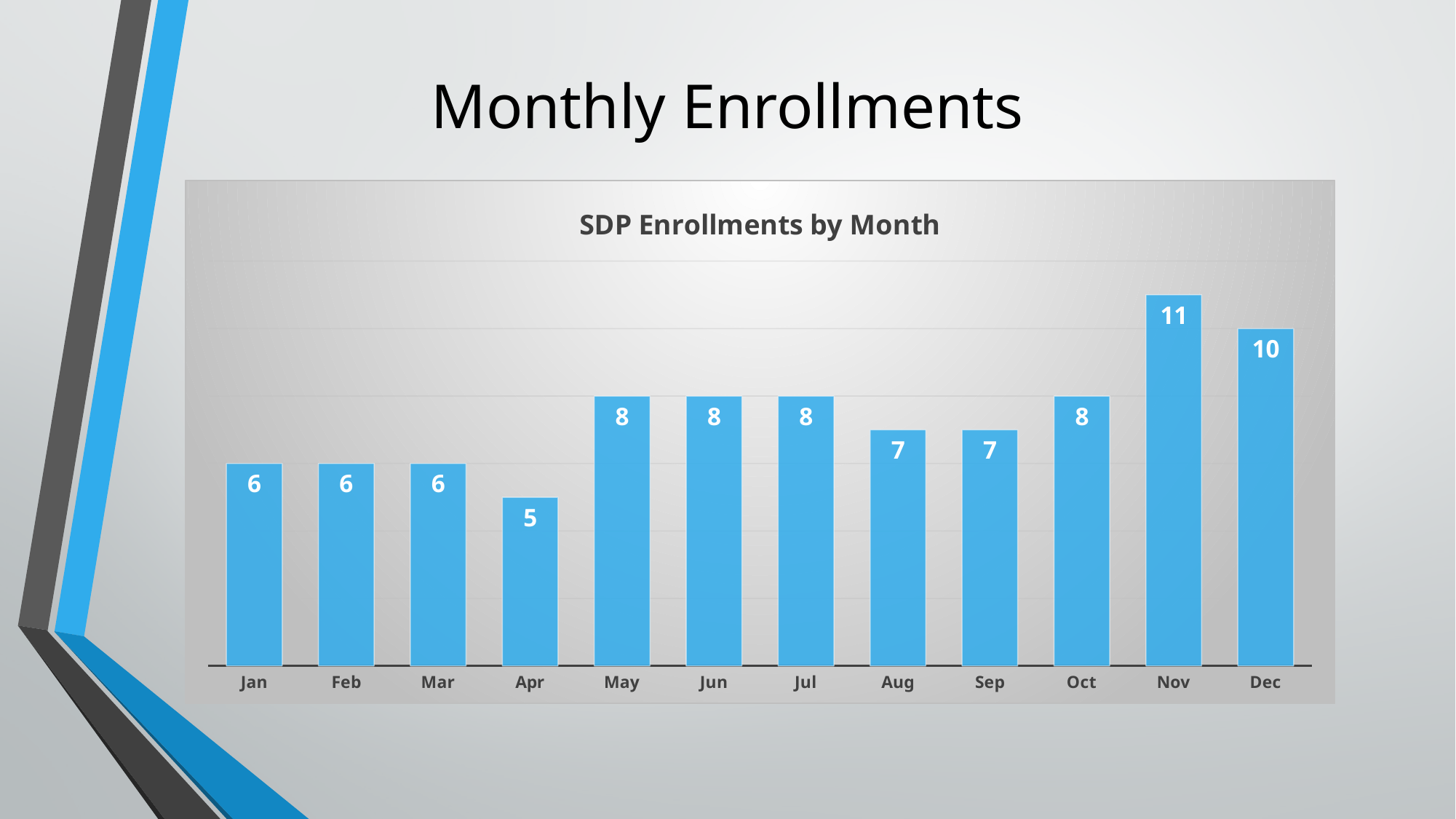
What kind of chart is shown on the slide? Bar chart Do the values rise or fall from Sep to Nov? Rise How many months are shown on the x axis? 12 What is the value for Apr? 5 Which month has the highest enrollments? Nov What is the value for Dec? 10 What is the difference between the values for Dec and Oct? 2 Which is larger, the value for Aug or the value for Oct? Oct What is the title of the chart? SDP Enrollments by Month What is the difference between the values for Nov and Apr? 6 Which month has the lowest enrollments? Apr What is the value for Nov? 11